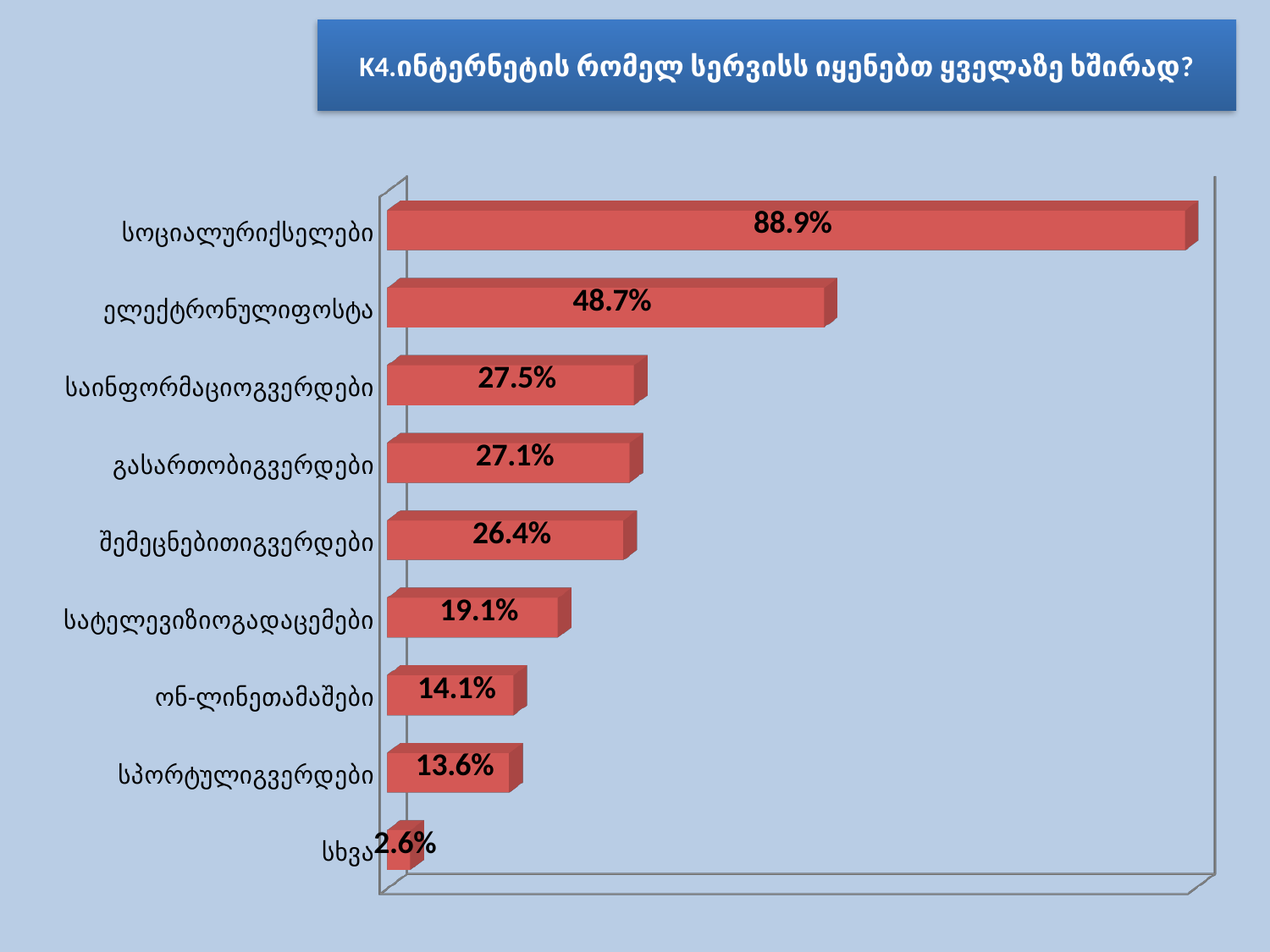
What is the difference between the values for სოციალურიქსელები and ელექტრონულიფოსტა? 40.2% Which category has the lowest value? სხვა What is the difference between the values for ონ-ლინეთამაშები and სპორტულიგვერდები? 0.5% What kind of chart is shown on the slide? bar chart What is the value for სოციალურიქსელები? 88.9% What is the value for სატელევიზიოგადაცემები? 19.1% What is the title of the chart? K4.ინტერნეტის რომელ სერვისს იყენებთ ყველაზე ხშირად? Which is larger, the value for საინფორმაციოგვერდები or the value for სატელევიზიოგადაცემები? საინფორმაციოგვერდები What is the value for ელექტრონულიფოსტა? 48.7% What is the value for სხვა? 2.6% How many categories are shown in the chart? 9 Which category has the highest value? სოციალურიქსელები